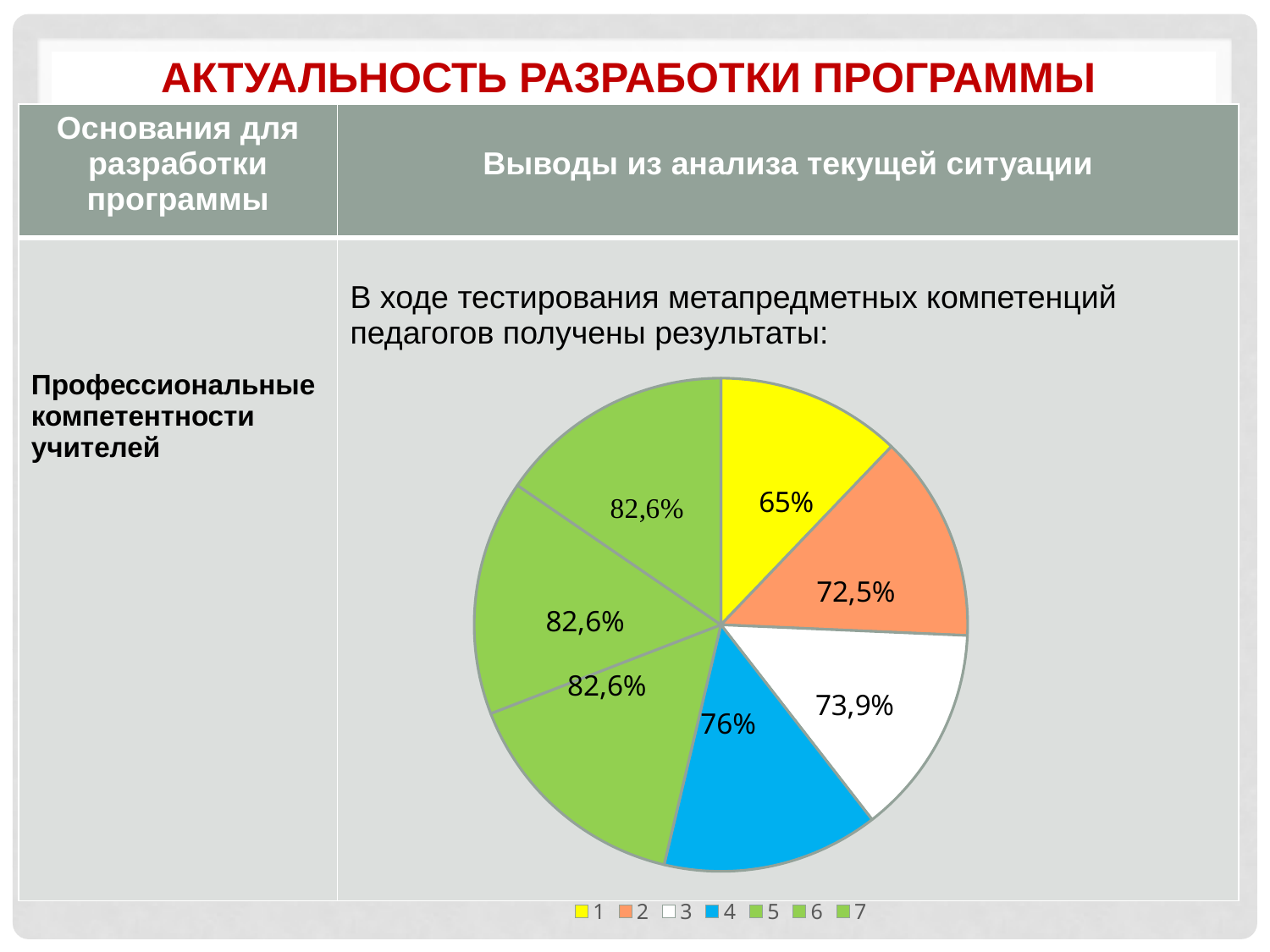
What kind of chart is shown on the slide? pie chart How many slices does the pie chart have? 7 Which has the larger value, category 2 or category 4? category 4 How many entries does the legend of the pie chart list? 7 What is the value shown for category 3 in the pie chart? 73,9% What is the highest value labelled in the pie chart? 82,6% What colour is the slice for category 1 in the pie chart? yellow Which category has the lowest value in the pie chart? 1 What is the value shown for category 2 in the pie chart? 72,5% What is the difference between the values for category 4 and category 1? 11 percentage points What is the value shown for category 4 in the pie chart? 76% What is the value shown for category 1 in the pie chart? 65%